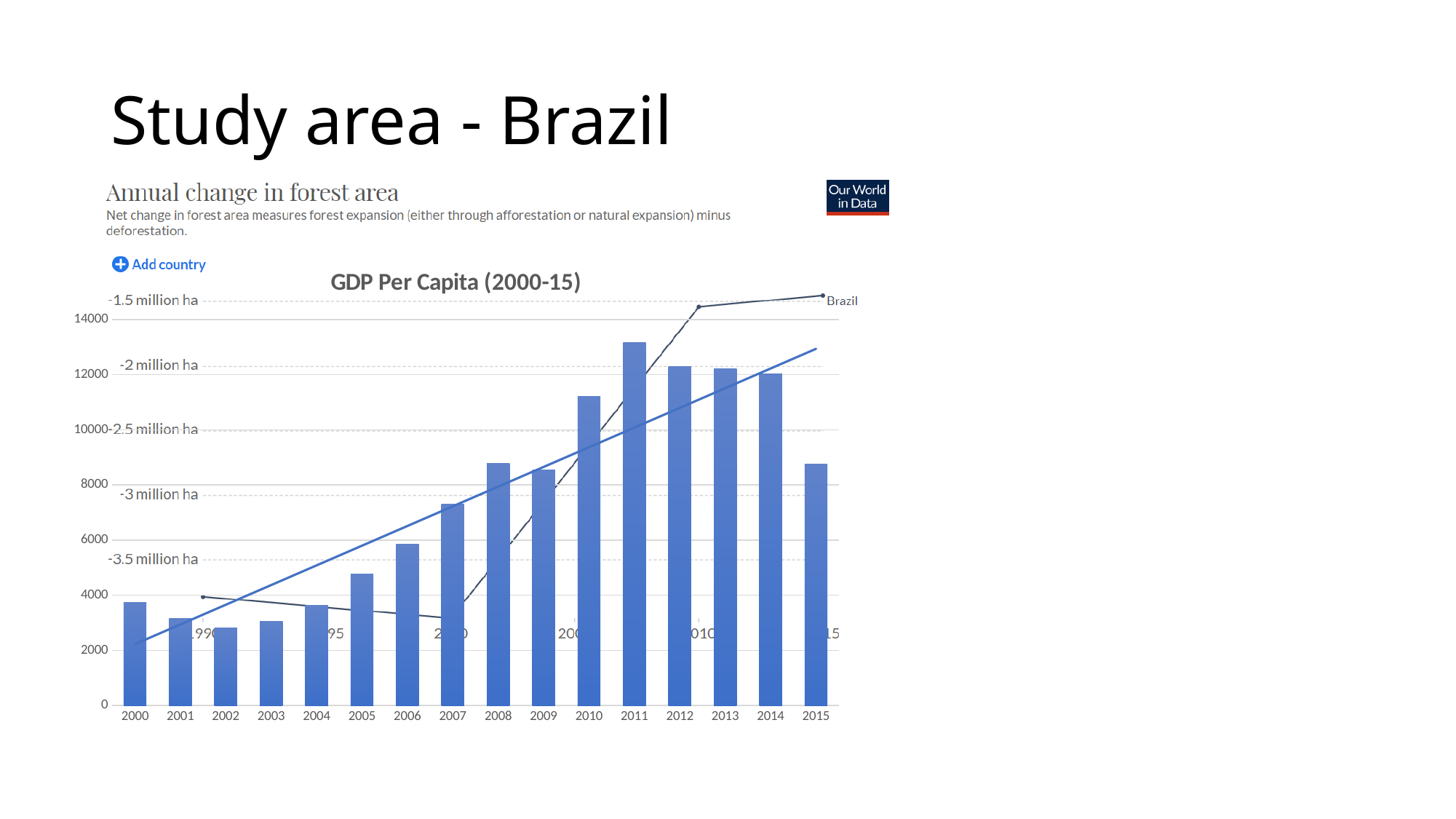
In the GDP Per Capita (2000-15) chart, which year has the larger value, 2005 or 2007? 2007 In the GDP Per Capita (2000-15) chart, which year has the highest bar? 2011 In the GDP Per Capita (2000-15) chart, how many years are shown on the x axis? 16 In the GDP Per Capita (2000-15) chart, which year has the lowest bar? 2002 What is the title of the bar chart on the slide? GDP Per Capita (2000-15) In the GDP Per Capita (2000-15) chart, do the bar values generally rise or fall from 2002 to 2011? rise In the GDP Per Capita (2000-15) chart, which year has the larger value, 2010 or 2015? 2010 In the GDP Per Capita (2000-15) chart, is the value for 2000 greater or less than 4000? less In the GDP Per Capita (2000-15) chart, what kind of chart is used to show the GDP values? bar chart In the GDP Per Capita (2000-15) chart, is the value for 2015 greater or less than 8000? greater In the GDP Per Capita (2000-15) chart, is the value for 2011 greater or less than 12000? greater